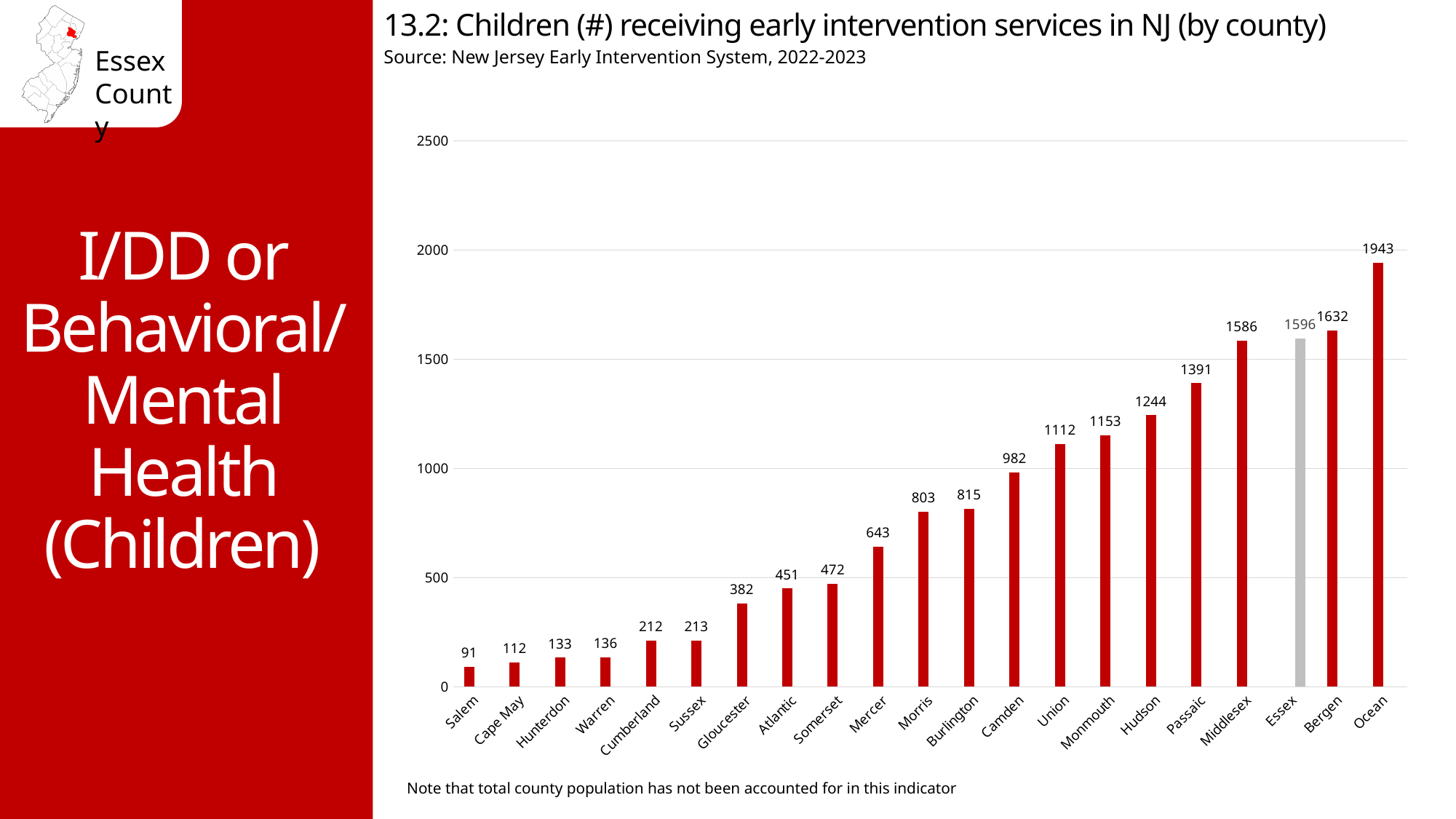
What is the value shown for Ocean County? 1943 What is the difference between the values for Bergen and Essex? 36 What type of chart is shown on the slide? bar chart How many counties are shown on the chart? 21 What is the value shown for Mercer County? 643 How many children are receiving early intervention services in Essex County? 1596 Which county has the lowest number of children receiving early intervention services? Salem Which county's bar is shown in grey rather than red? Essex Is the value for Passaic greater or less than 1500? less What is the difference between the values for Ocean and Salem? 1852 Which county has a higher value, Camden or Burlington? Camden Which county has the highest number of children receiving early intervention services? Ocean